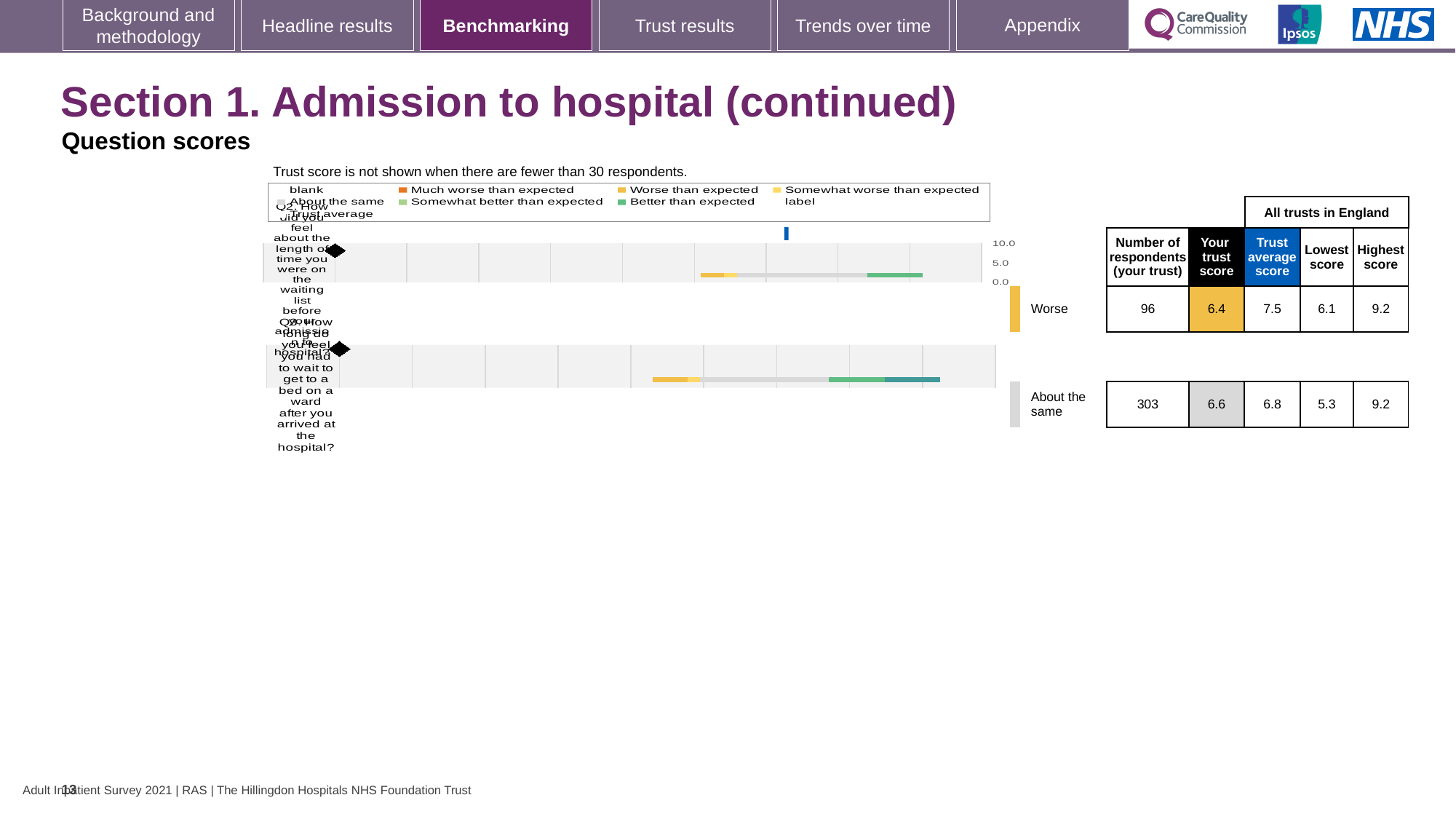
What kind of chart is used to show the question scores? Bar chart How many questions are plotted on the chart? 2 What is the lowest score across all trusts in England for Q2? 6.1 What is the highest score across all trusts in England for Q3? 9.2 What is the difference between the trust average score and this trust's score for Q2? 1.1 What is the trust average score across all trusts in England for Q2? 7.5 How is this trust's Q2 score categorised relative to expectations? Worse What is the trust score for Q2 (how did you feel about the length of time on the waiting list before admission)? 6.4 How many respondents answered Q2 for this trust? 96 What is the trust score for Q3 (how long did you feel you had to wait to get to a bed on a ward)? 6.6 Which question has the higher trust score, Q2 or Q3? Q3 How many respondents answered Q3 for this trust? 303